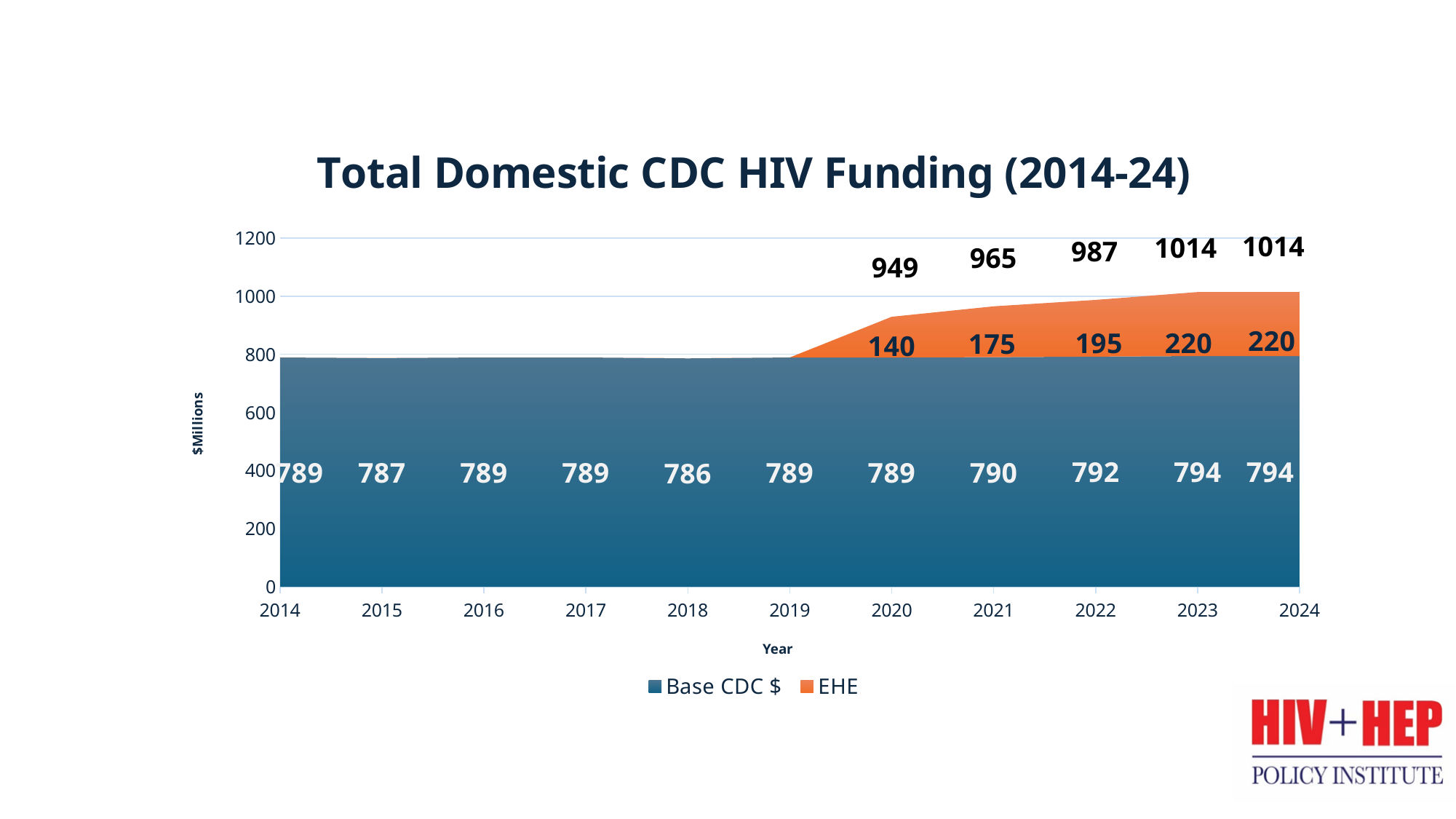
What is the difference between the EHE values for 2023 and 2020? 80 Which year has the lowest EHE value? 2020 What is the total funding shown for 2022? 987 What kind of chart is shown on the slide? Area chart How many years are shown on the x axis? 11 What is the EHE value for 2021? 175 Which year has the lowest Base CDC $ value? 2018 What is the difference between the total funding for 2021 and 2020? 16 Does the EHE value rise or fall from 2020 to 2023? Rise How many series does the legend list? 2 What is the Base CDC $ value for 2018? 786 Which is larger, the EHE value for 2022 or the EHE value for 2021? 2022